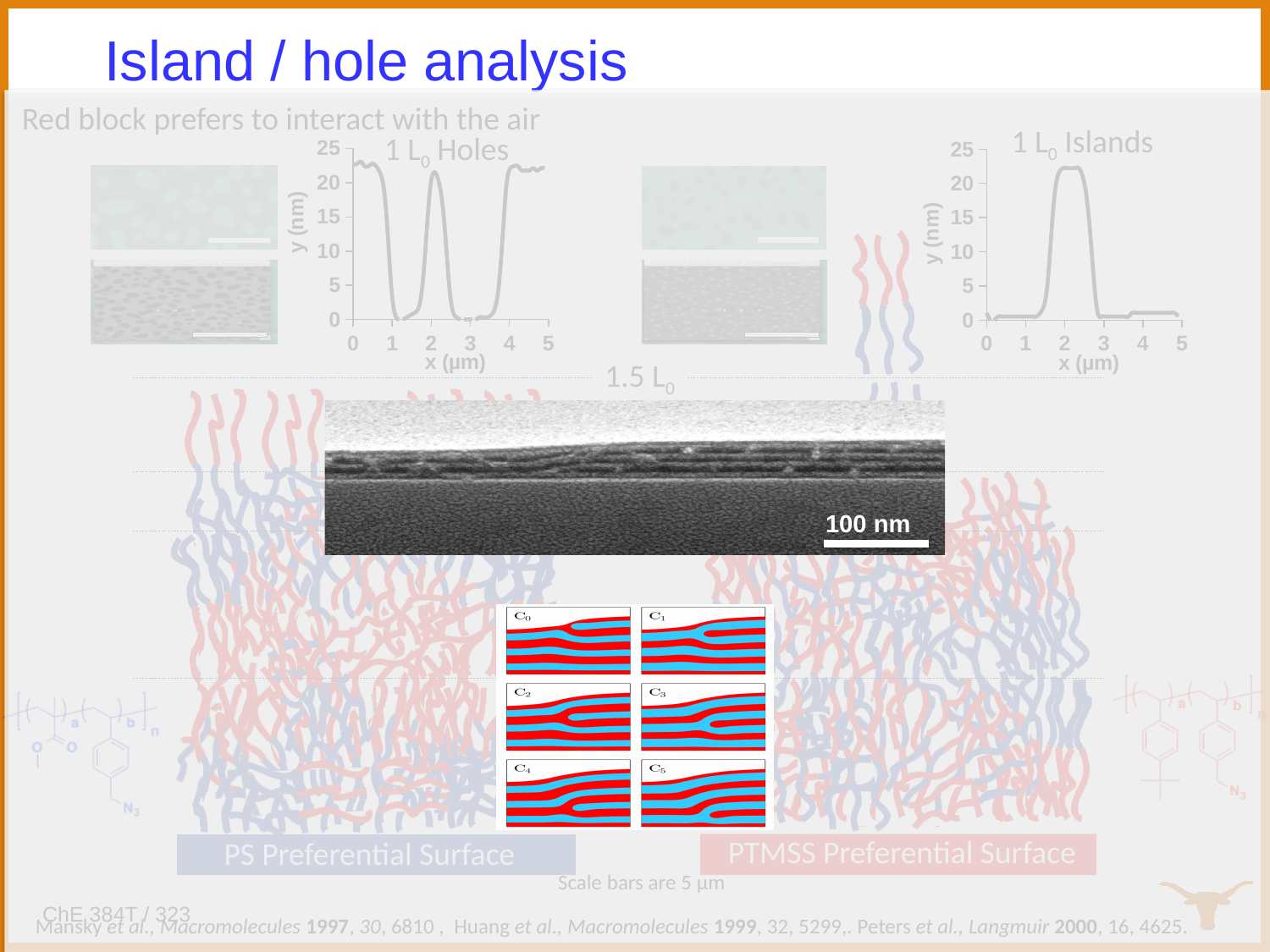
In the "1 L0 Islands" chart, is the value at x = 0.5 μm larger or smaller than the value at x = 2.5 μm? smaller In the "1 L0 Holes" chart, does the value rise or fall between x = 0.5 μm and x = 1 μm? fall In the "1 L0 Islands" chart, is the value at x = 4 μm greater or less than 5 nm? less In the "1 L0 Holes" chart, is the value at x = 3 μm greater or less than 10 nm? less In the "1 L0 Islands" chart, does the value rise or fall between x = 1.5 μm and x = 2 μm? rise In the "1 L0 Islands" chart, what is the label of the x axis? x (μm) In the "1 L0 Islands" chart, is the value at x = 2 μm greater or less than 10 nm? greater In the "1 L0 Holes" chart, what is the label of the y axis? y (nm) What kind of chart is the "1 L0 Islands" chart? line chart What kind of chart is the "1 L0 Holes" chart? line chart How many line charts are shown on the slide? 2